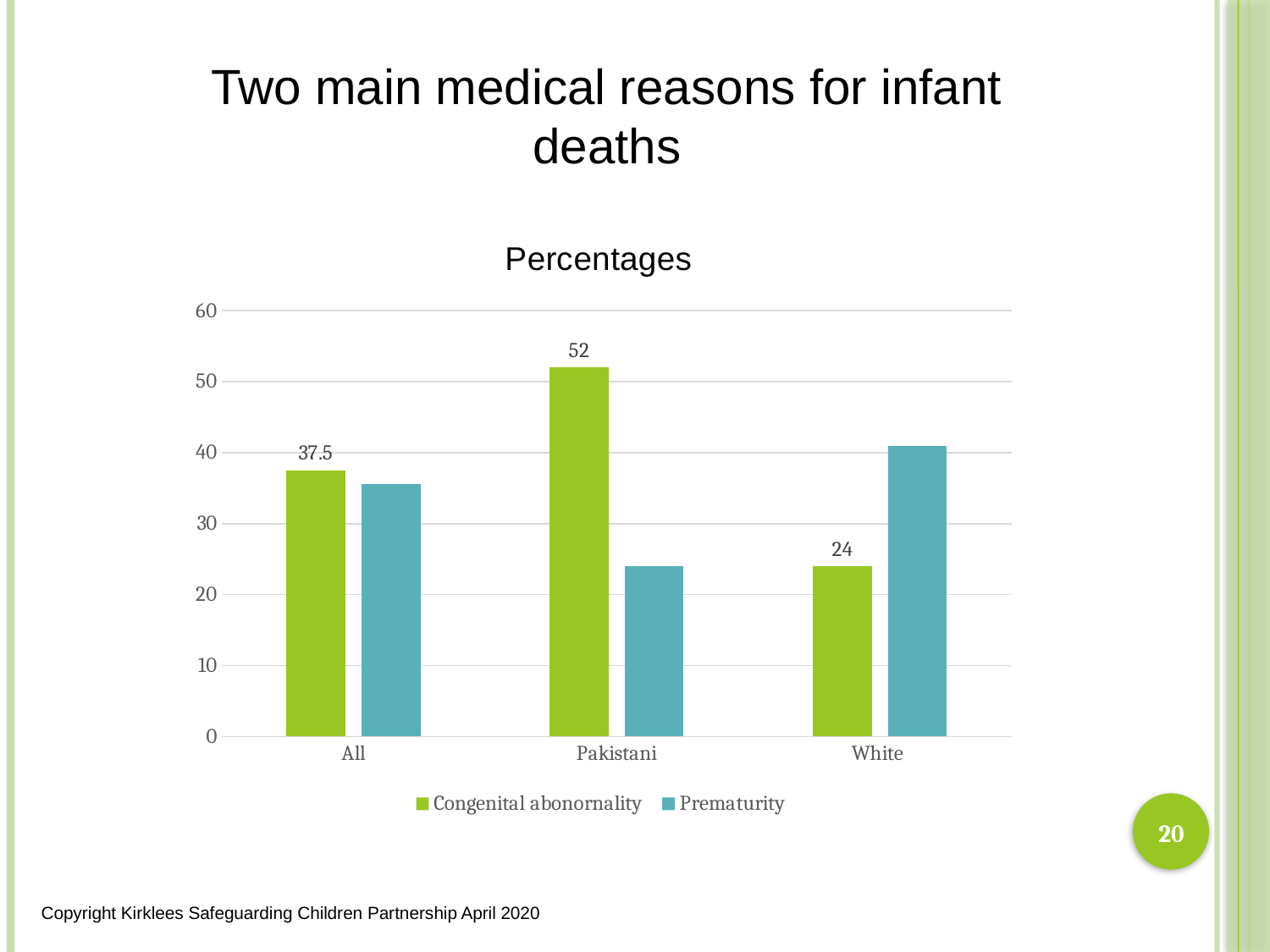
What is the Congenital abonornality percentage for the All group? 37.5 What is the difference between the Congenital abonornality percentages for Pakistani and All? 14.5 What is the difference between the Congenital abonornality percentages for Pakistani and White? 28 Is the Prematurity value for the Pakistani group greater or less than 30? less Is the Prematurity value for the White group greater or less than 30? greater How many groups are shown on the x axis? 3 For the Pakistani group, which is larger: Congenital abonornality or Prematurity? Congenital abonornality How many series does the legend list? 2 What is the Congenital abonornality percentage for the White group? 24 Which group has the lowest Congenital abonornality percentage? White Which group has the highest Congenital abonornality percentage? Pakistani What is the Congenital abonornality percentage for the Pakistani group? 52